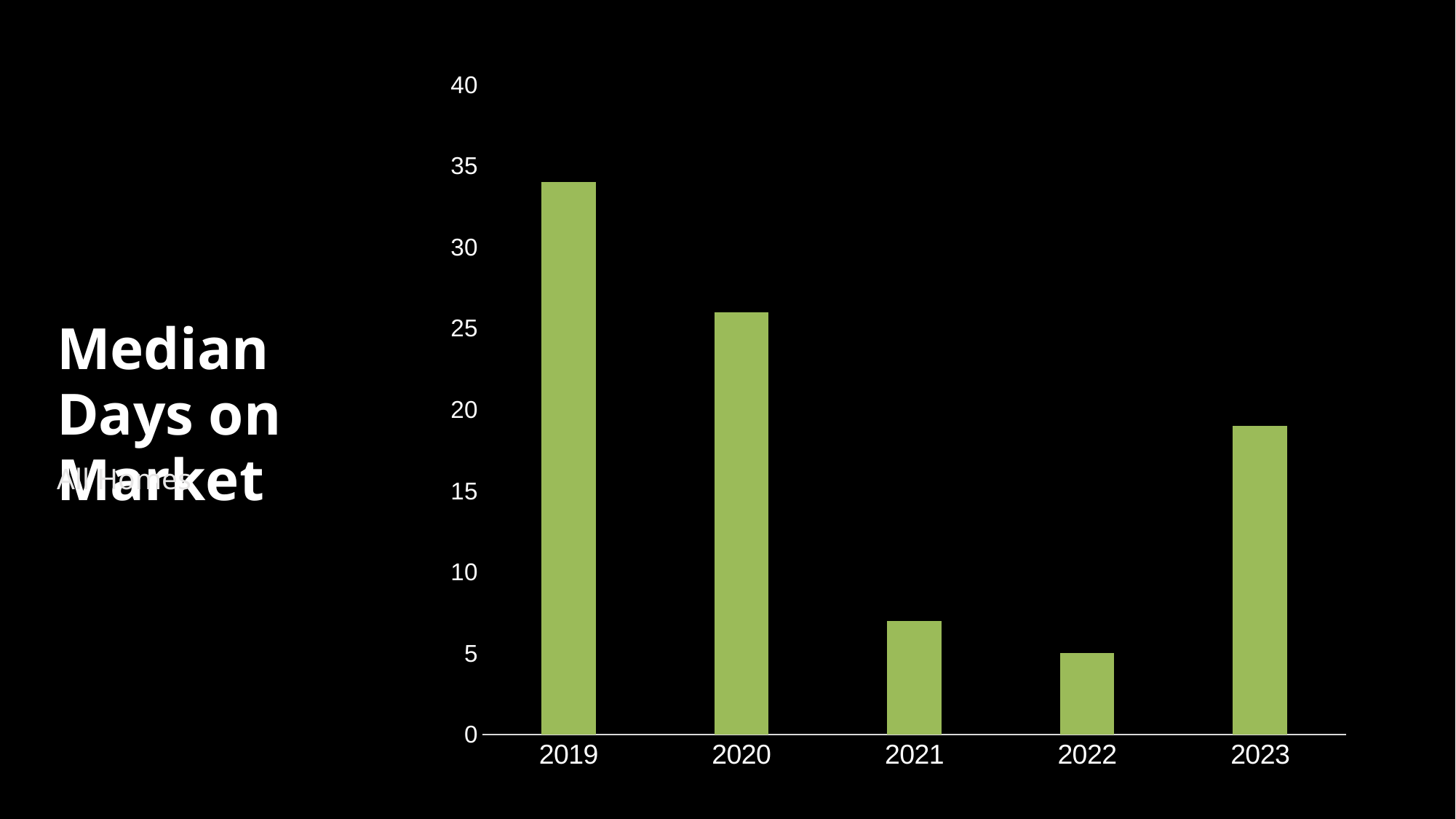
What is the value for 2022? 5 What kind of chart is shown on the slide? bar chart Is the value for 2019 greater or less than 30? greater How many years are shown on the x axis of the chart? 5 Is the value for 2021 greater or less than 10? less Which year has the highest median days on market? 2019 Is the value for 2023 greater or less than 20? less Which year has the lowest median days on market? 2022 What colour are the bars in the chart? green Do the values rise or fall from 2019 to 2022? fall Which is larger, the value for 2020 or the value for 2023? 2020